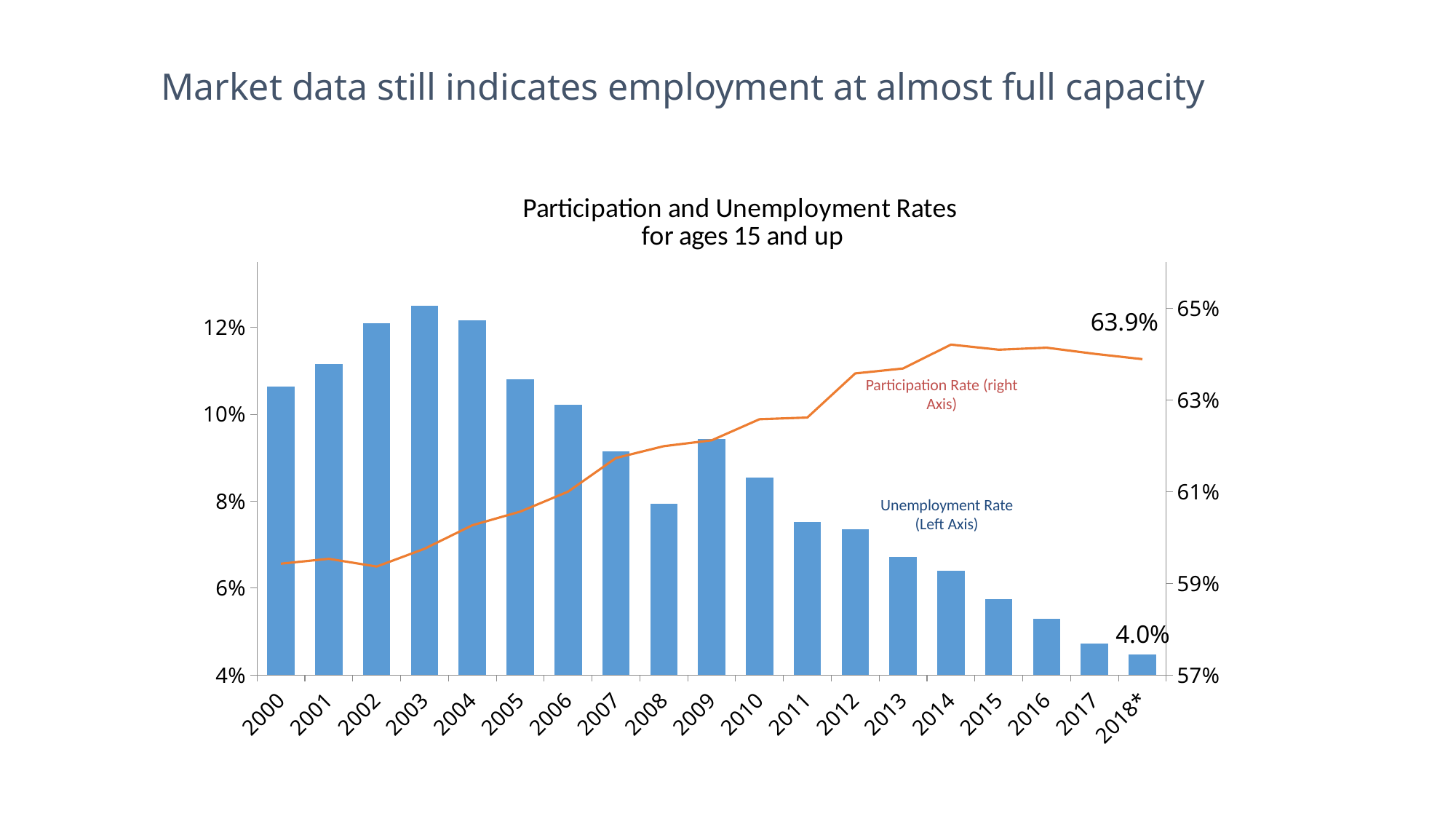
What is the unemployment rate shown for 2018*? 4.0% Which axis is the participation rate plotted against? right axis Is the unemployment rate for 2000 greater or less than 10%? greater What kind of chart is used to show the unemployment rate? bar chart What is the participation rate shown for 2018*? 63.9% In which year is the unemployment rate bar the lowest? 2018* Is the participation rate for 2012 greater or less than 63%? greater How many years are shown on the x axis of the chart? 19 Which year has the higher unemployment rate, 2002 or 2008? 2002 Does the unemployment rate rise or fall from 2009 to 2018*? fall In which year is the unemployment rate bar the highest? 2003 Is the unemployment rate for 2016 greater or less than 6%? less